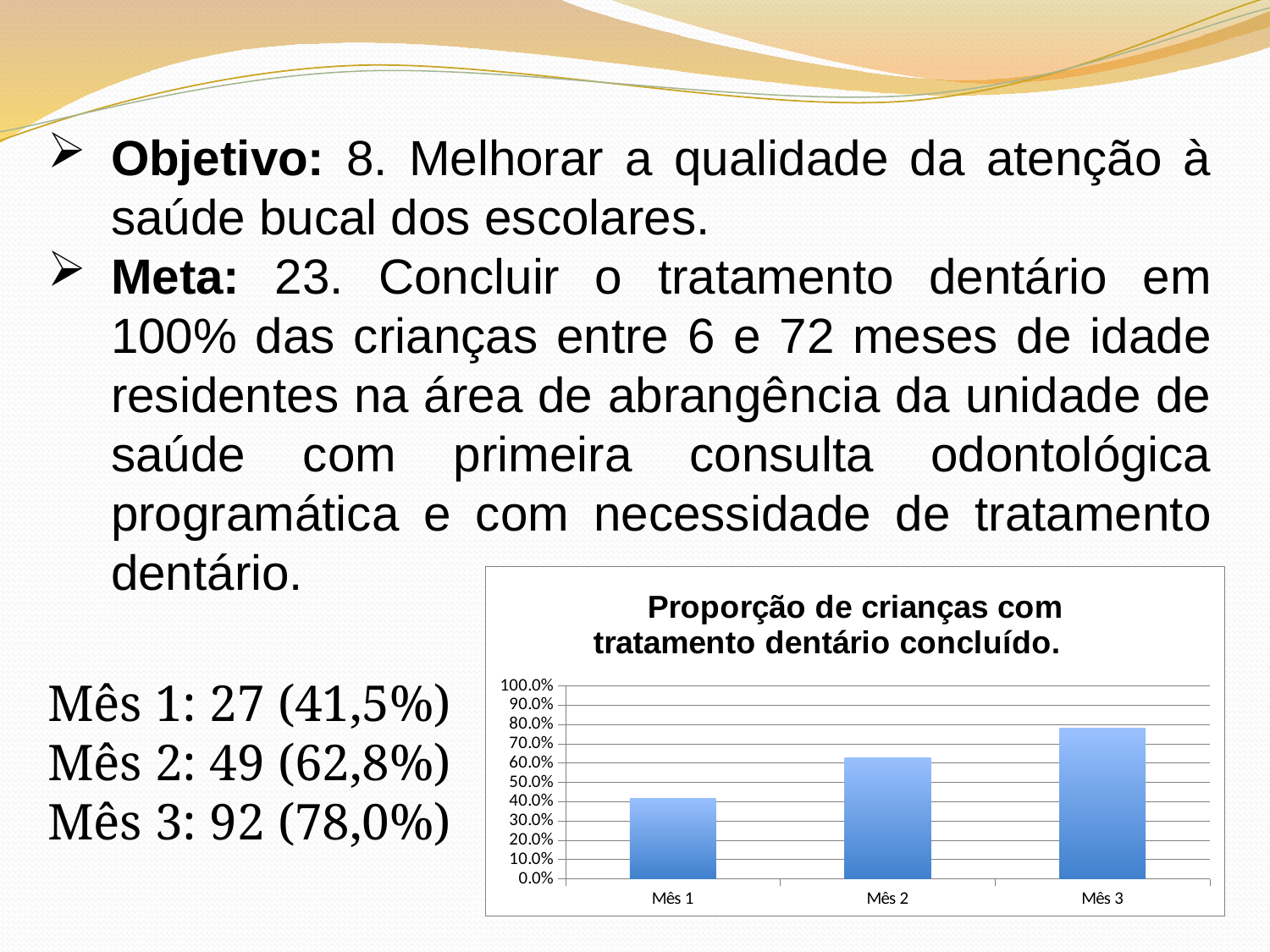
Do the values rise or fall from Mês 1 to Mês 3? rise What kind of chart is shown on the slide? bar chart Which month has the lowest proportion in the chart? Mês 1 Is the value for Mês 1 greater or less than 50.0%? less Which is larger, the value for Mês 1 or the value for Mês 2? Mês 2 What is the title of the chart? Proporção de crianças com tratamento dentário concluído. Is the value for Mês 3 greater or less than 80.0%? less Is the value for Mês 2 greater or less than 60.0%? greater According to the slide, what proportion of children had completed dental treatment in Mês 3? 78,0% How many categories are shown on the x axis of the chart? 3 Which month has the highest proportion in the chart? Mês 3